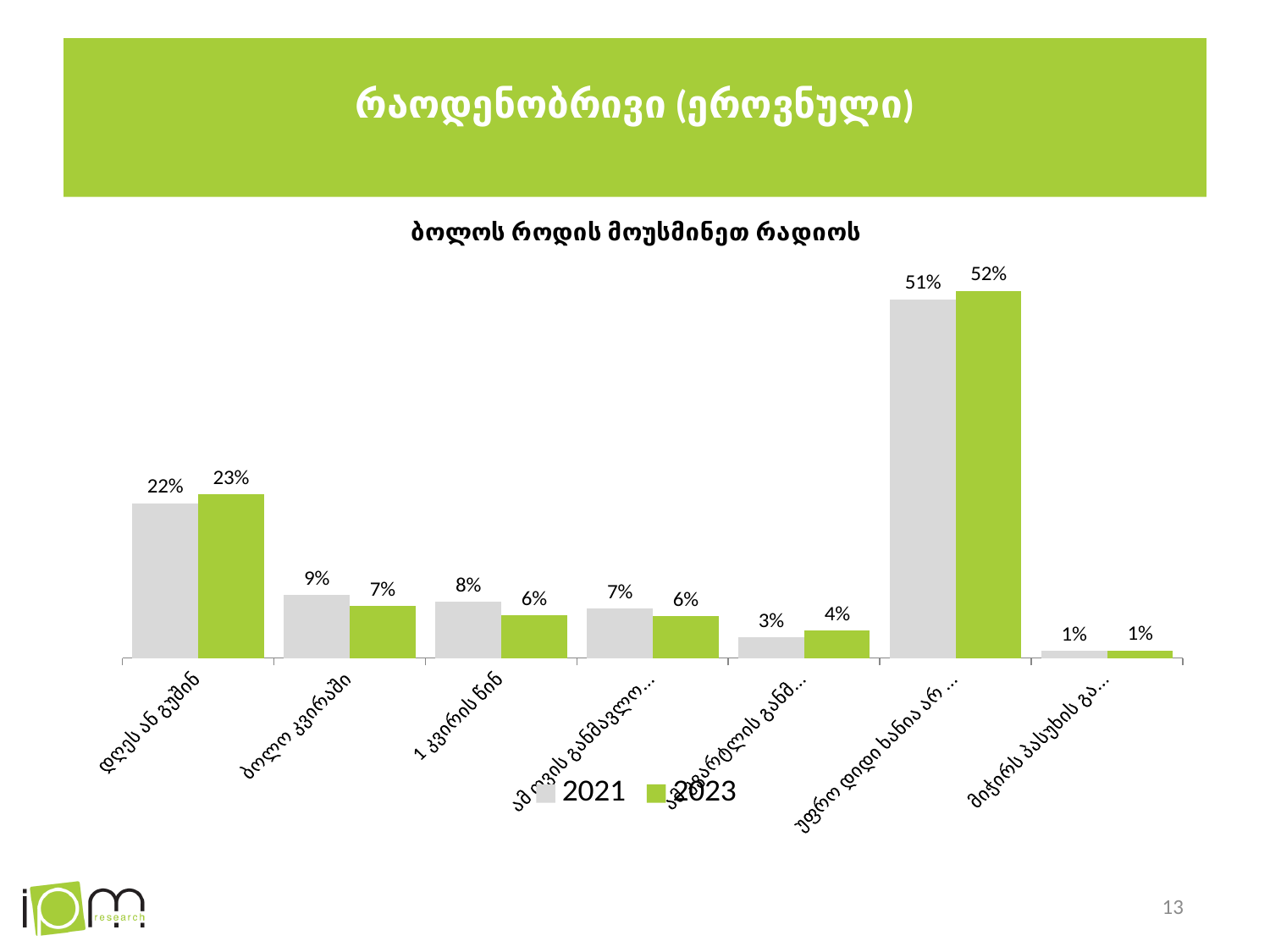
Which is larger for "1 კვირის წინ": the 2021 value or the 2023 value? 2021 What is the 2023 value for "1 კვირის წინ"? 6% What is the lowest 2021 value shown in the chart? 1% How many categories are shown on the x axis of the chart? 7 What kind of chart is shown on the slide? Bar chart How many series does the legend list? 2 What is the highest 2023 value shown in the chart? 52% What is the 2021 value for "დღეს ან გუშინ"? 22% What is the 2021 value for "ბოლო კვირაში"? 9% What is the difference between the 2021 and 2023 values for "ბოლო კვირაში"? 2% What is the title of the chart? ბოლოს როდის მოუსმინეთ რადიოს What is the 2023 value for "დღეს ან გუშინ"? 23%